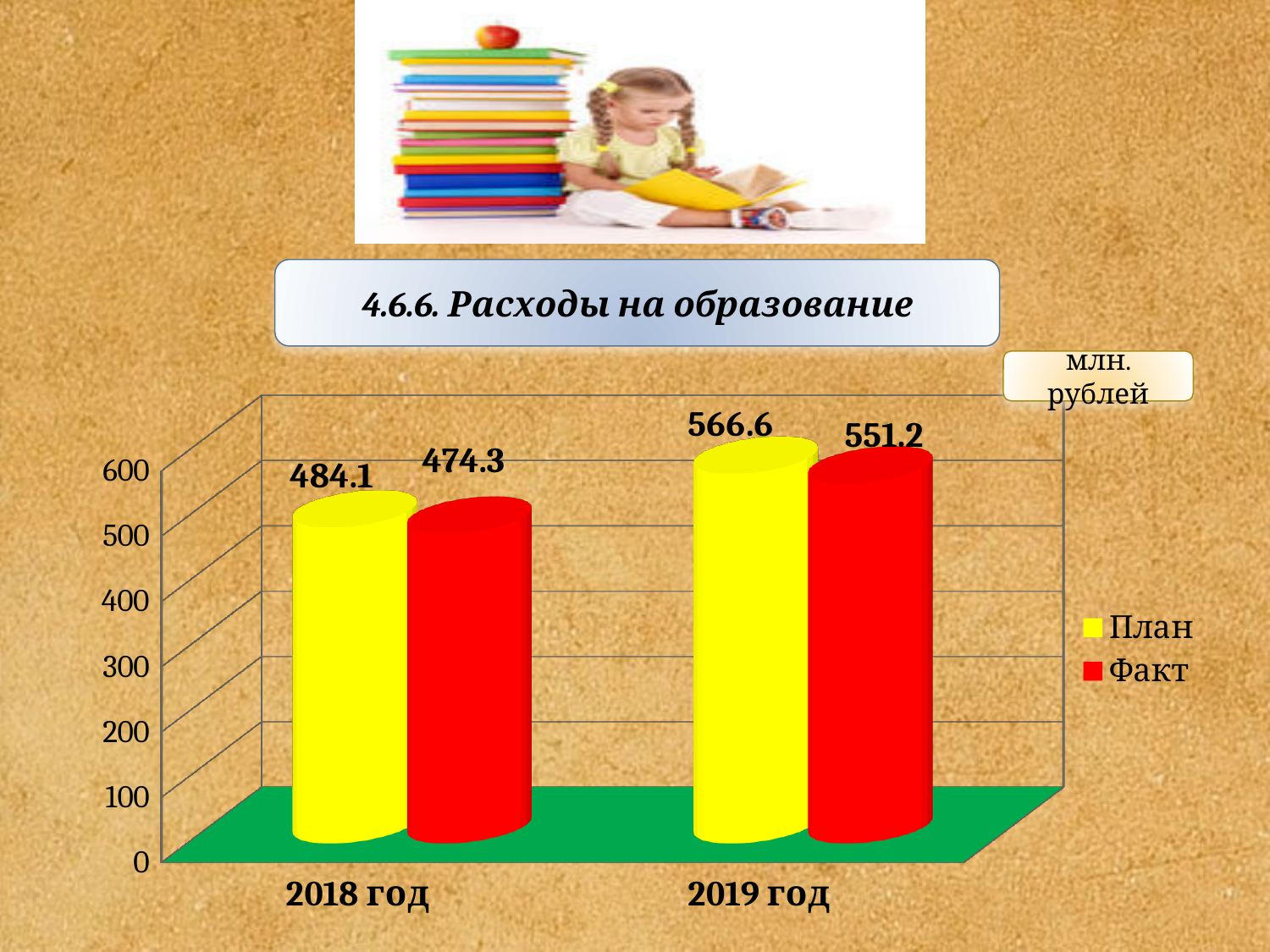
Is the Факт value for 2019 год greater or less than 500? greater Which year has the lowest Факт value? 2018 год What is the Факт value for 2018 год? 474.3 What is the difference between the План values for 2019 год and 2018 год? 82.5 How many years are shown on the x axis? 2 What is the Факт value for 2019 год? 551.2 Which year has the highest План value? 2019 год What is the difference between План and Факт for 2019 год? 15.4 What kind of chart is shown? bar chart Which is larger for 2018 год, План or Факт? План How many series does the legend list? 2 What is the План value for 2018 год? 484.1